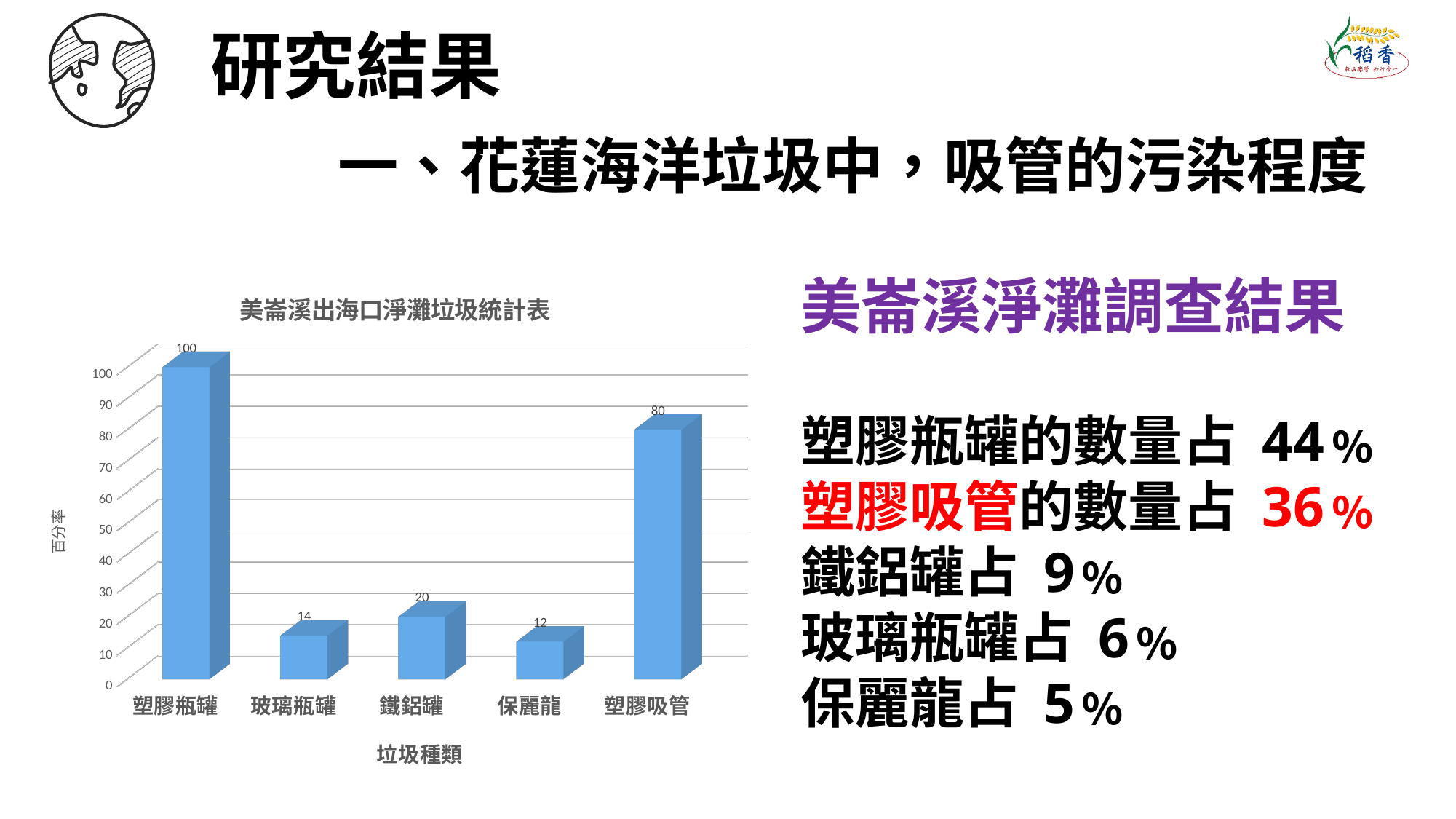
Is the value for 鐵鋁罐 greater or less than 50? less What is the difference between the values for 塑膠瓶罐 and 塑膠吸管? 20 What kind of chart is shown on the slide? bar chart What is the value for 塑膠瓶罐 in the chart? 100 Which category has the lowest value in the chart? 保麗龍 Which category has the highest value in the chart? 塑膠瓶罐 Which is larger, the value for 鐵鋁罐 or the value for 玻璃瓶罐? 鐵鋁罐 What is the title of the chart? 美崙溪出海口淨灘垃圾統計表 What is the value for 保麗龍 in the chart? 12 How many categories are shown on the x axis of the chart? 5 What is the value for 塑膠吸管 in the chart? 80 What is the value for 玻璃瓶罐 in the chart? 14